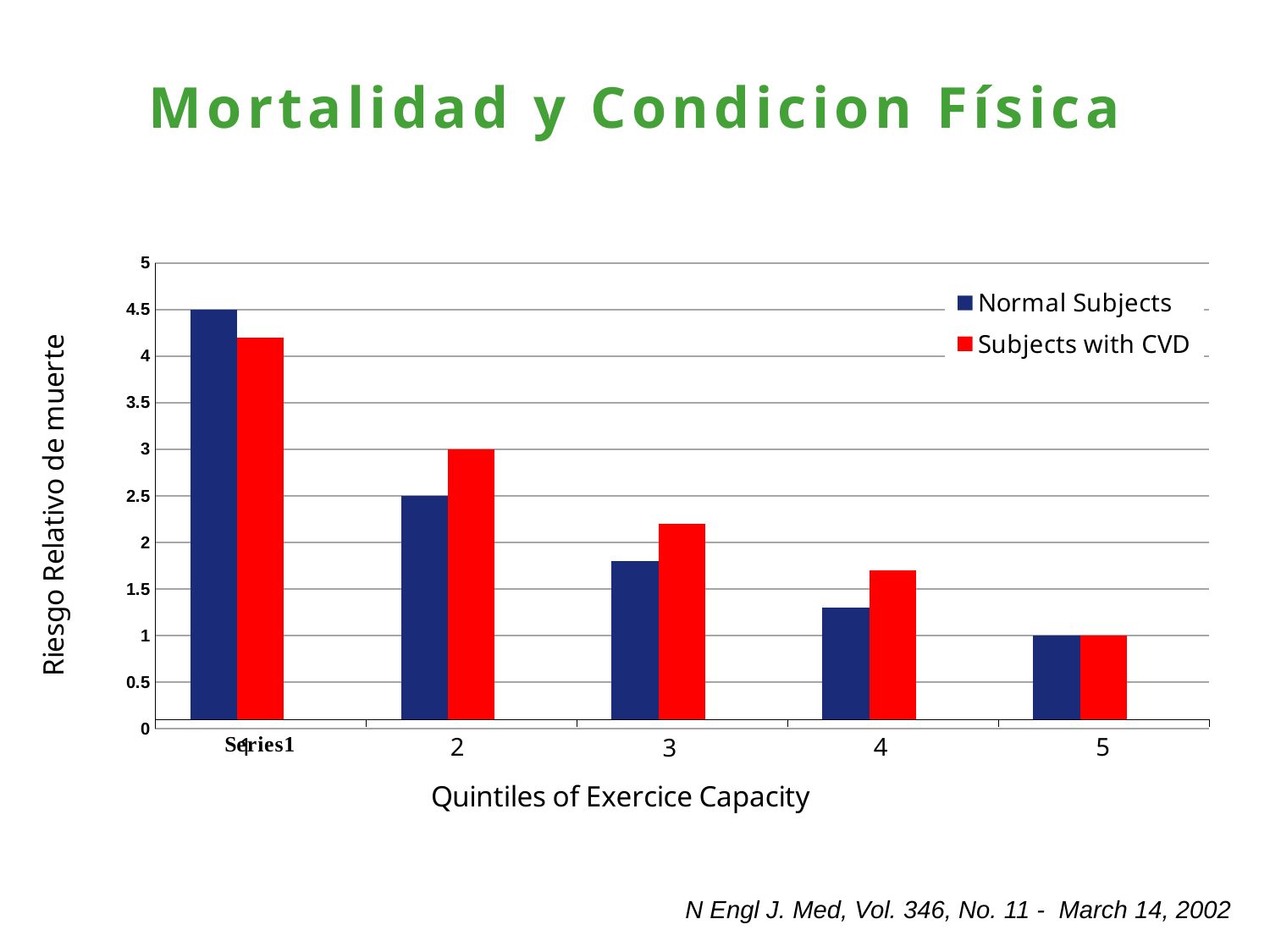
How many quintile groups are plotted along the x axis? 5 What is the value for Normal Subjects in the leftmost (first) quintile group? 4.5 How many series does the legend list? 2 What is the value for Normal Subjects in quintile 2? 2.5 Which quintile has the highest value for Subjects with CVD? the first (leftmost) quintile Is the value for Subjects with CVD in quintile 3 greater or less than 2? greater What is the value for Normal Subjects in quintile 5? 1 Do the values for Normal Subjects rise or fall as the quintile of exercise capacity increases from left to right? fall What is the value for Subjects with CVD in quintile 2? 3 What kind of chart is shown on the slide? bar chart In quintile 3, which series has the larger value, Normal Subjects or Subjects with CVD? Subjects with CVD Is the value for Normal Subjects in quintile 4 greater or less than 1.5? less